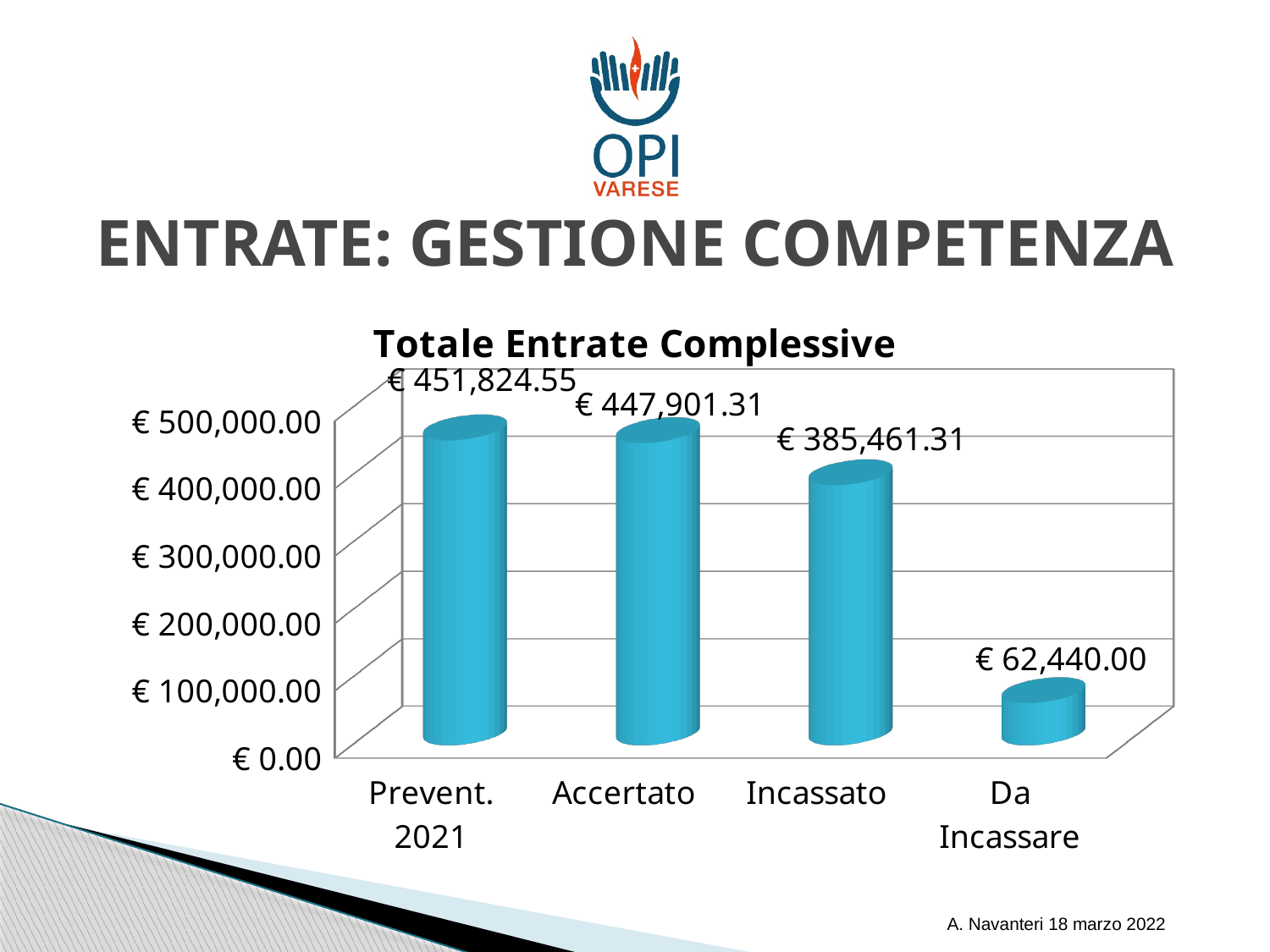
What kind of chart is shown on the slide? Bar chart What is the value for Da Incassare? € 62,440.00 What is the value for Incassato? € 385,461.31 What is the title of the chart? Totale Entrate Complessive What is the difference between Accertato and Incassato? € 62,440.00 Which category has the highest value? Prevent. 2021 What is the value for Accertato in the Totale Entrate Complessive chart? € 447,901.31 Which category has the lowest value? Da Incassare What is the value for Prevent. 2021? € 451,824.55 How many categories are shown in the chart? 4 What is the difference between Prevent. 2021 and Accertato? € 3,923.24 Which is larger, Incassato or Da Incassare? Incassato